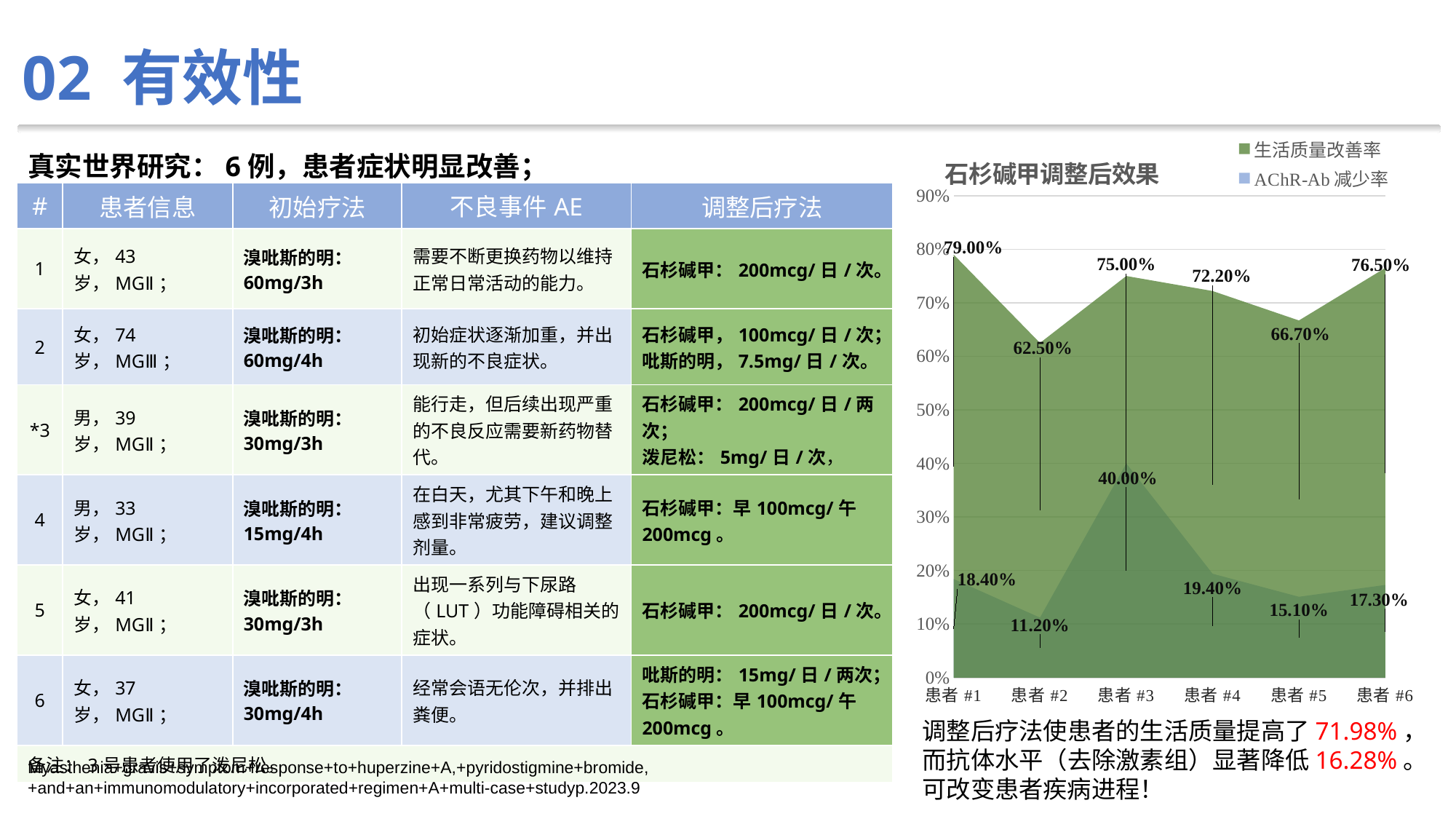
How many patients are shown on the x axis of the chart? 6 Which patient has the lowest 生活质量改善率? 患者 #2 What is the title of the chart? 石杉碱甲调整后效果 What is the difference between the 生活质量改善率 of 患者 #1 and 患者 #2? 16.50% Which is larger, the 生活质量改善率 of 患者 #3 or of 患者 #6? 患者 #6 What is the AChR-Ab 减少率 value for 患者 #3? 40.00% What is the 生活质量改善率 value for 患者 #5? 66.70% What kind of chart is shown on the slide? Area chart Which patient has the lowest AChR-Ab 减少率? 患者 #2 What is the 生活质量改善率 value for 患者 #1? 79.00% How many series does the chart legend list? 2 Which patient has the highest AChR-Ab 减少率? 患者 #3